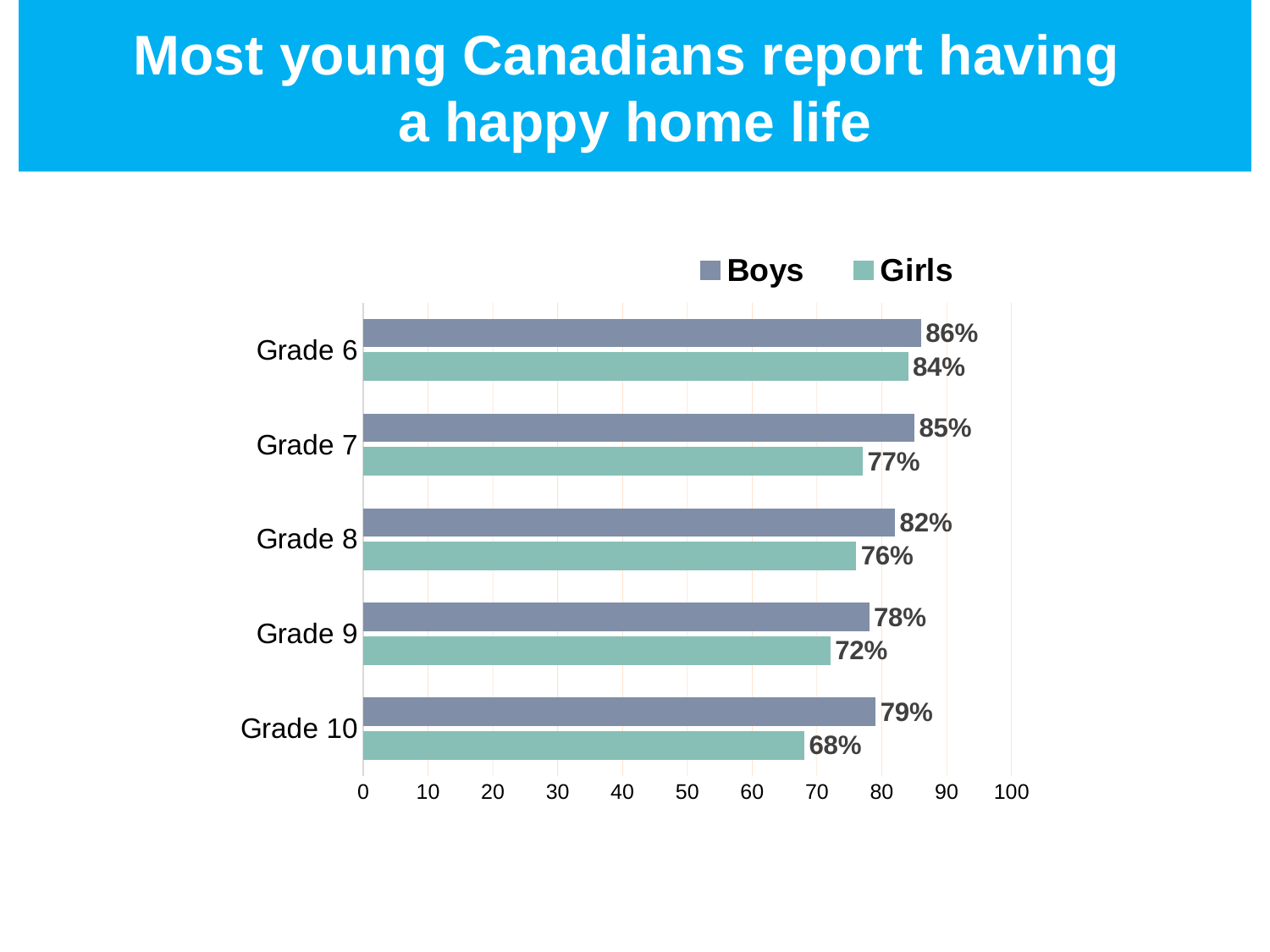
What kind of chart is shown on the slide? Bar chart Which grade has the lowest value for Boys? Grade 9 What is the value for Girls in Grade 7? 77% How many series does the legend list? 2 What is the value for Girls in Grade 10? 68% Which is larger, the Boys value for Grade 9 or the Girls value for Grade 6? Girls value for Grade 6 Which grade has the lowest value for Girls? Grade 10 How many grade categories are shown on the chart? 5 Which grade has the highest value for Girls? Grade 6 What is the difference between Boys and Girls in Grade 10? 11% What percentage of Grade 6 boys report having a happy home life? 86% What is the difference between Boys and Girls in Grade 8? 6%